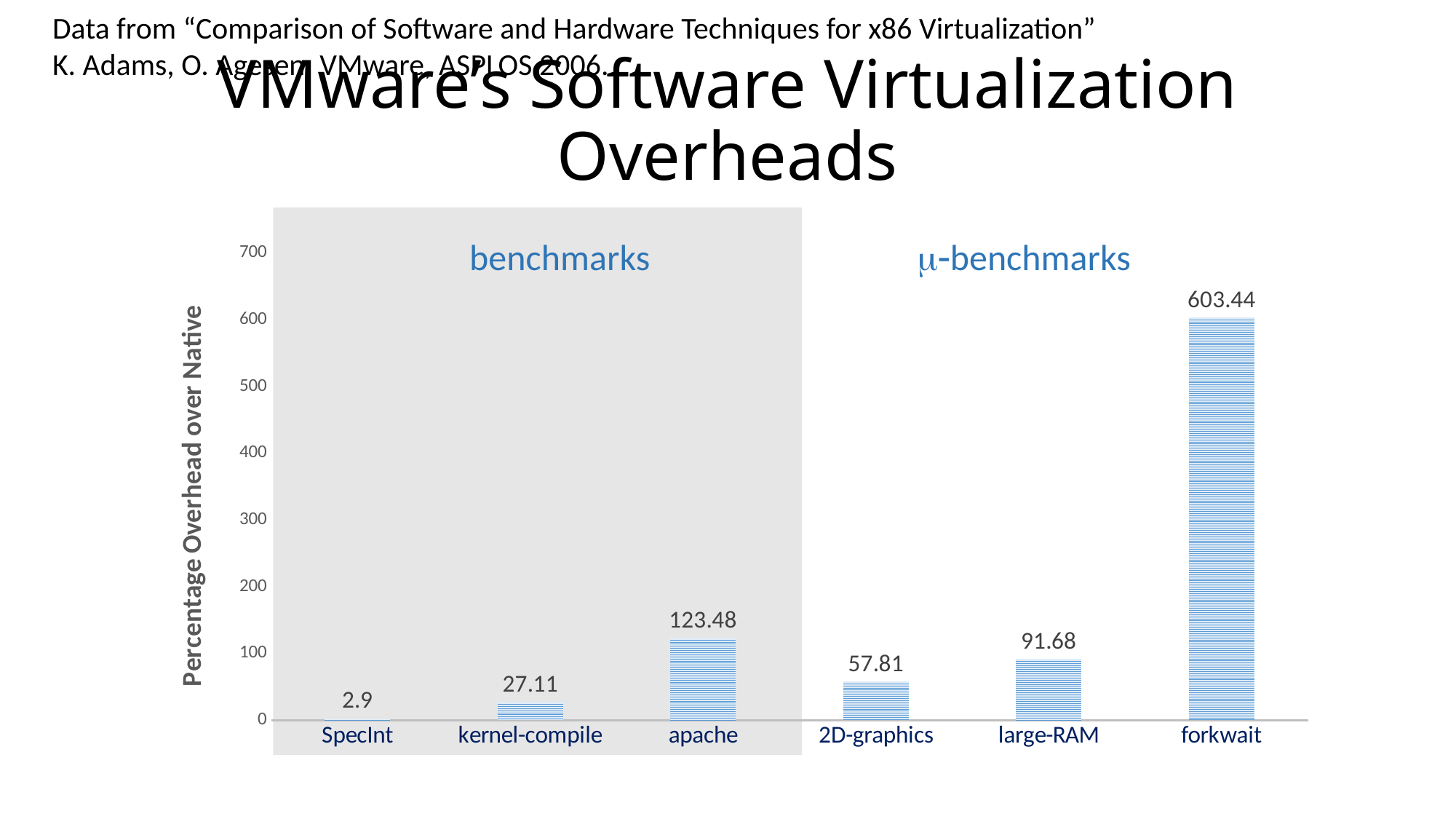
Which benchmark has the highest percentage overhead over native? forkwait What kind of chart is shown on the slide? Bar chart What is the label of the vertical axis? Percentage Overhead over Native Which group of benchmarks is shown on the shaded grey background? benchmarks What is the percentage overhead over native for SpecInt? 2.9 What is the percentage overhead over native for apache? 123.48 Which benchmark has the lowest percentage overhead over native? SpecInt What is the percentage overhead over native for large-RAM? 91.68 What is the percentage overhead over native for forkwait? 603.44 How many benchmarks are plotted on the chart? 6 What is the difference in percentage overhead between apache and kernel-compile? 96.37 Which has a larger percentage overhead, 2D-graphics or large-RAM? large-RAM